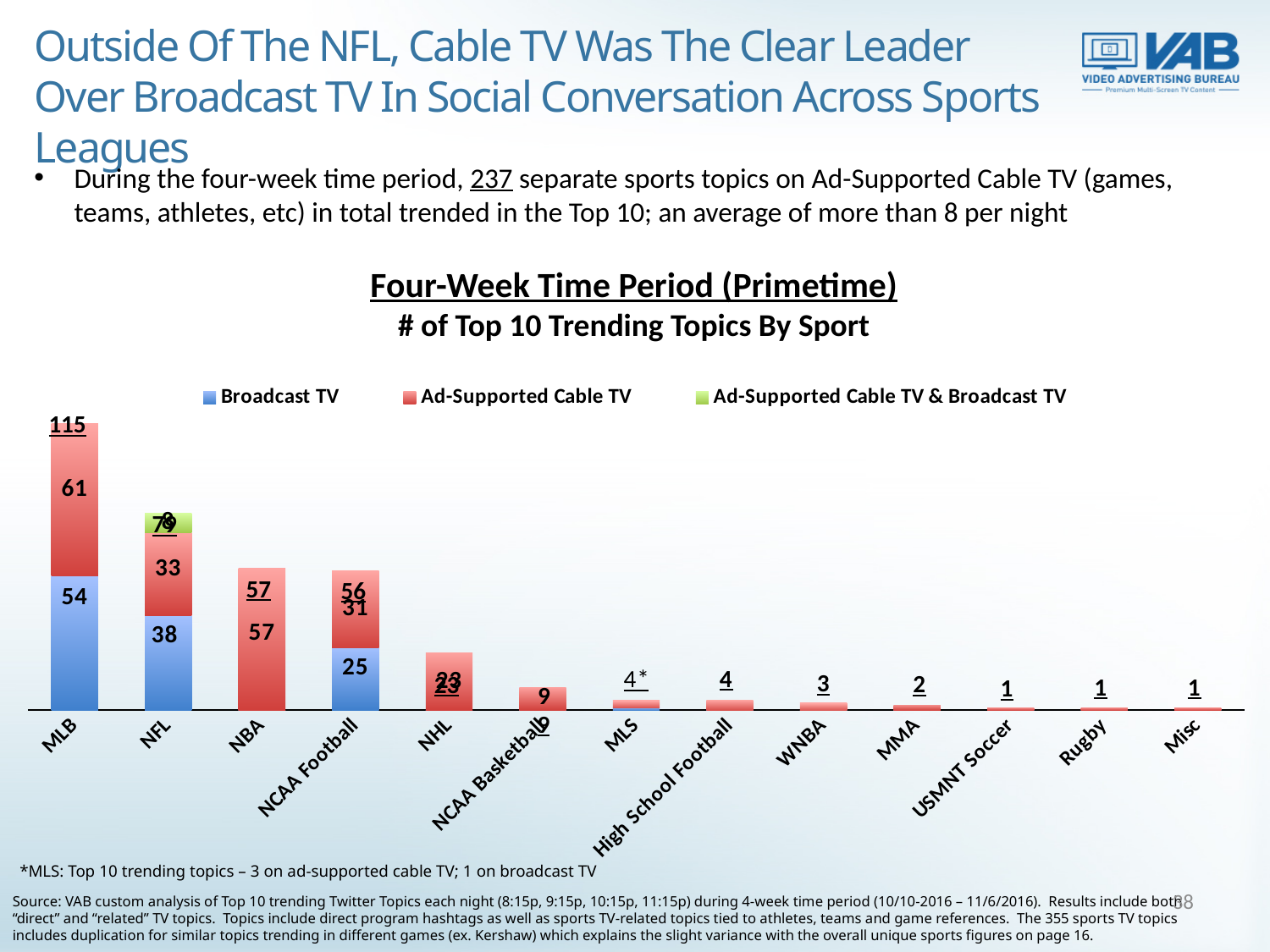
Do the total values generally rise or fall moving from left to right along the x axis? fall What is the Ad-Supported Cable TV value for NBA? 57 How many sports categories are shown along the x axis? 13 Which sport has the highest total number of Top 10 trending topics? MLB What kind of chart is shown on the slide? bar chart For NCAA Football, which is larger: the Ad-Supported Cable TV value or the Broadcast TV value? Ad-Supported Cable TV How many series does the legend list? 3 For MLB, how much larger is the Ad-Supported Cable TV value than the Broadcast TV value? 7 What is the total number of Top 10 trending topics for MLB? 115 What is the Ad-Supported Cable TV value for MLB? 61 What is the Broadcast TV value for MLB? 54 What is the Broadcast TV value for NCAA Football? 25